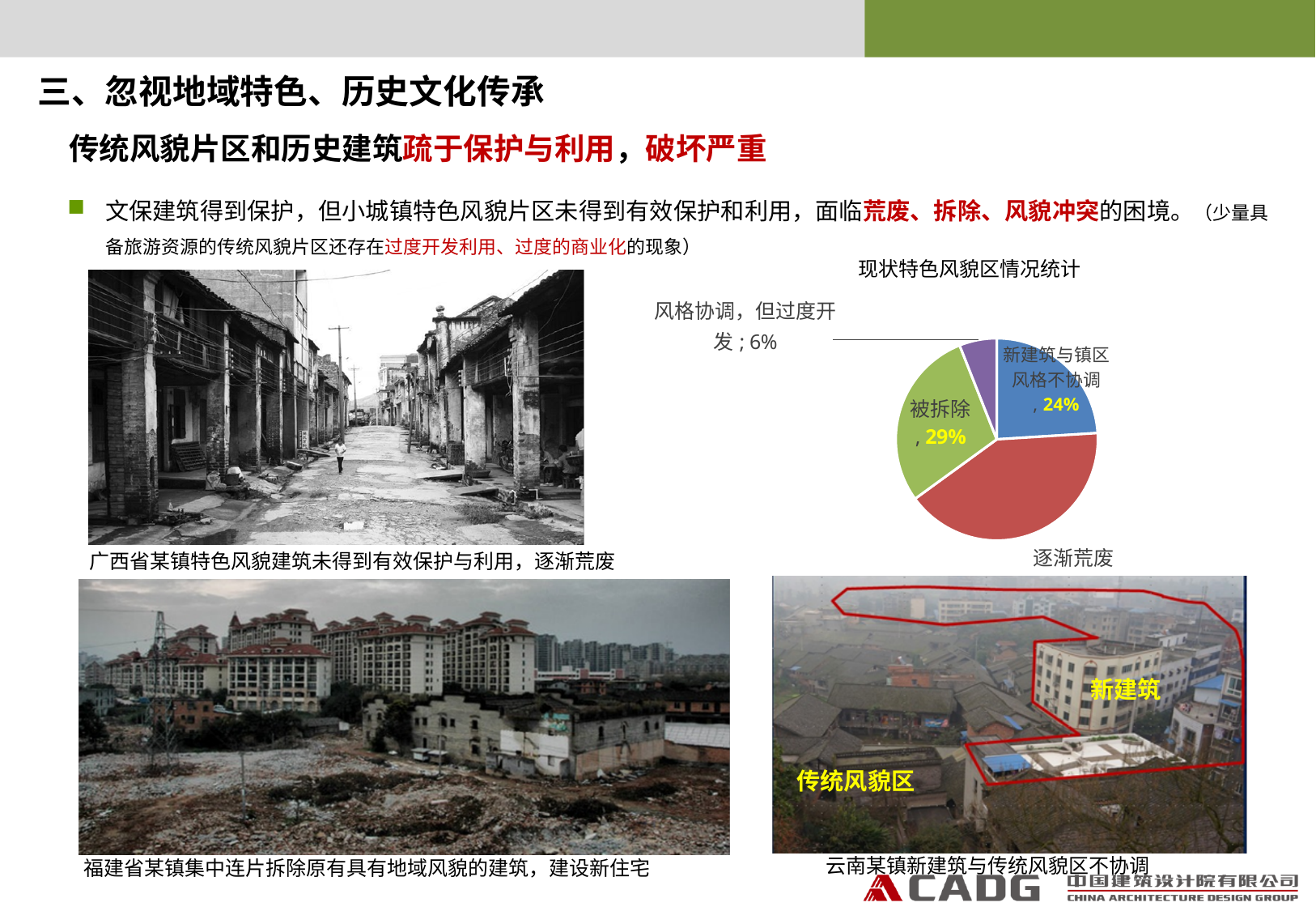
How many slices does the pie chart have? 4 What percentage is shown for 风格协调，但过度开发? 6% Which category has the smallest slice of the pie? 风格协调，但过度开发 What colour is the slice for 逐渐荒废? red What is the title of the chart? 现状特色风貌区情况统计 What is the difference between the share for 新建筑与镇区风格不协调 and the share for 风格协调，但过度开发? 18% What is the difference between the share for 被拆除 and the share for 新建筑与镇区风格不协调? 5% Which is larger, the share for 被拆除 or the share for 新建筑与镇区风格不协调? 被拆除 What percentage is shown for 被拆除? 29% What percentage is shown for 新建筑与镇区风格不协调? 24% Which category has the largest slice of the pie? 逐渐荒废 What kind of chart is shown on the slide? pie chart